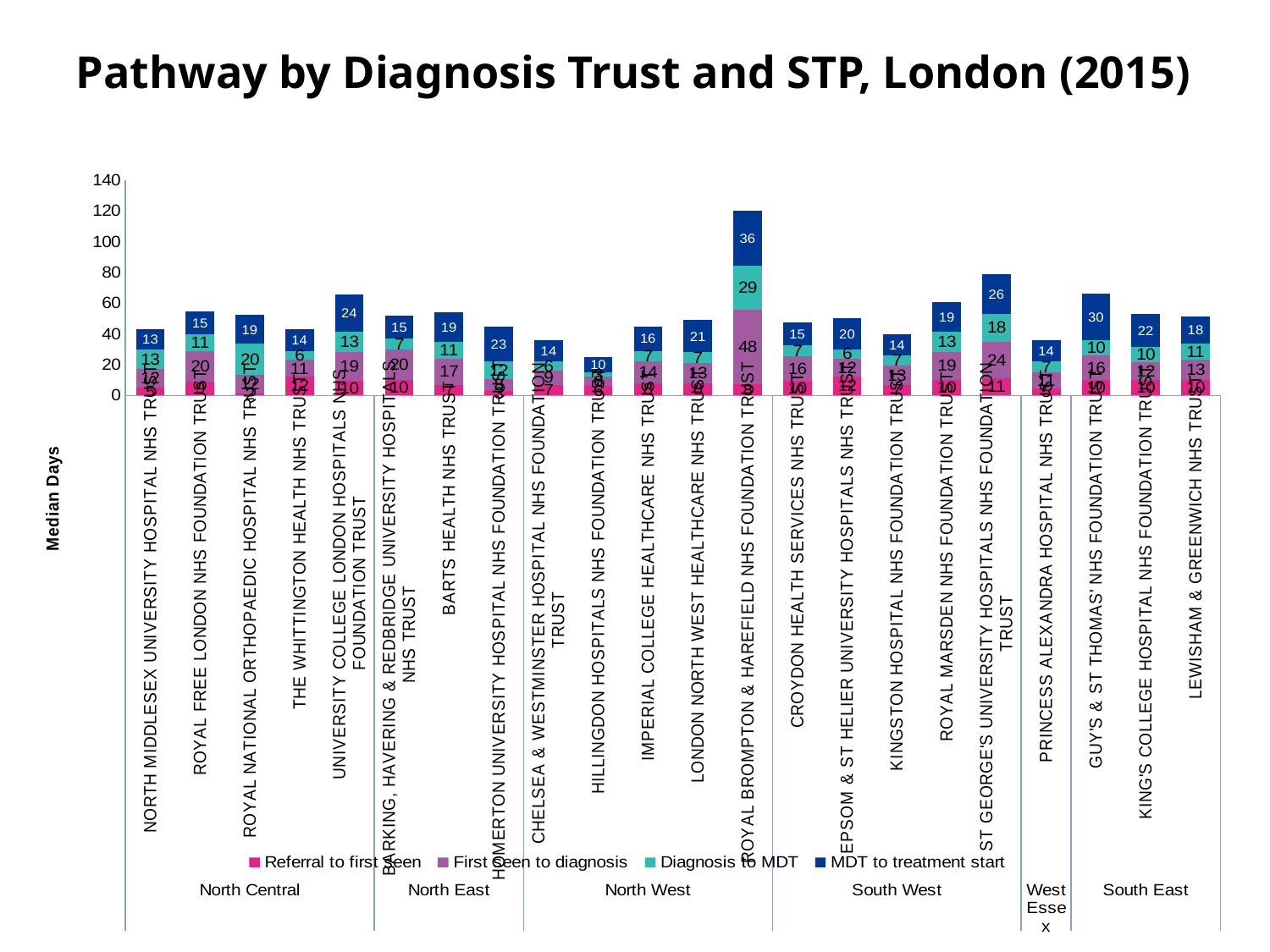
What is the MDT to treatment start value for St George's University Hospitals NHS Foundation Trust? 26 Which trust has the lowest total median days? Hillingdon Hospitals NHS Foundation Trust Is the total median days for Royal Brompton & Harefield NHS Foundation Trust greater or less than 100? greater What kind of chart is shown on the slide? Stacked bar chart How many series does the legend list? 4 What is the title of the y axis? Median Days What is the Diagnosis to MDT value for Royal Brompton & Harefield NHS Foundation Trust? 29 For Royal Brompton & Harefield NHS Foundation Trust, how much larger is the MDT to treatment start value than the Diagnosis to MDT value? 7 Which trust has the highest total median days? Royal Brompton & Harefield NHS Foundation Trust Which has the larger MDT to treatment start value: Guy's & St Thomas' NHS Foundation Trust or King's College Hospital NHS Foundation Trust? Guy's & St Thomas' NHS Foundation Trust What is the MDT to treatment start value for Royal Brompton & Harefield NHS Foundation Trust? 36 What is the MDT to treatment start value for Guy's & St Thomas' NHS Foundation Trust? 30